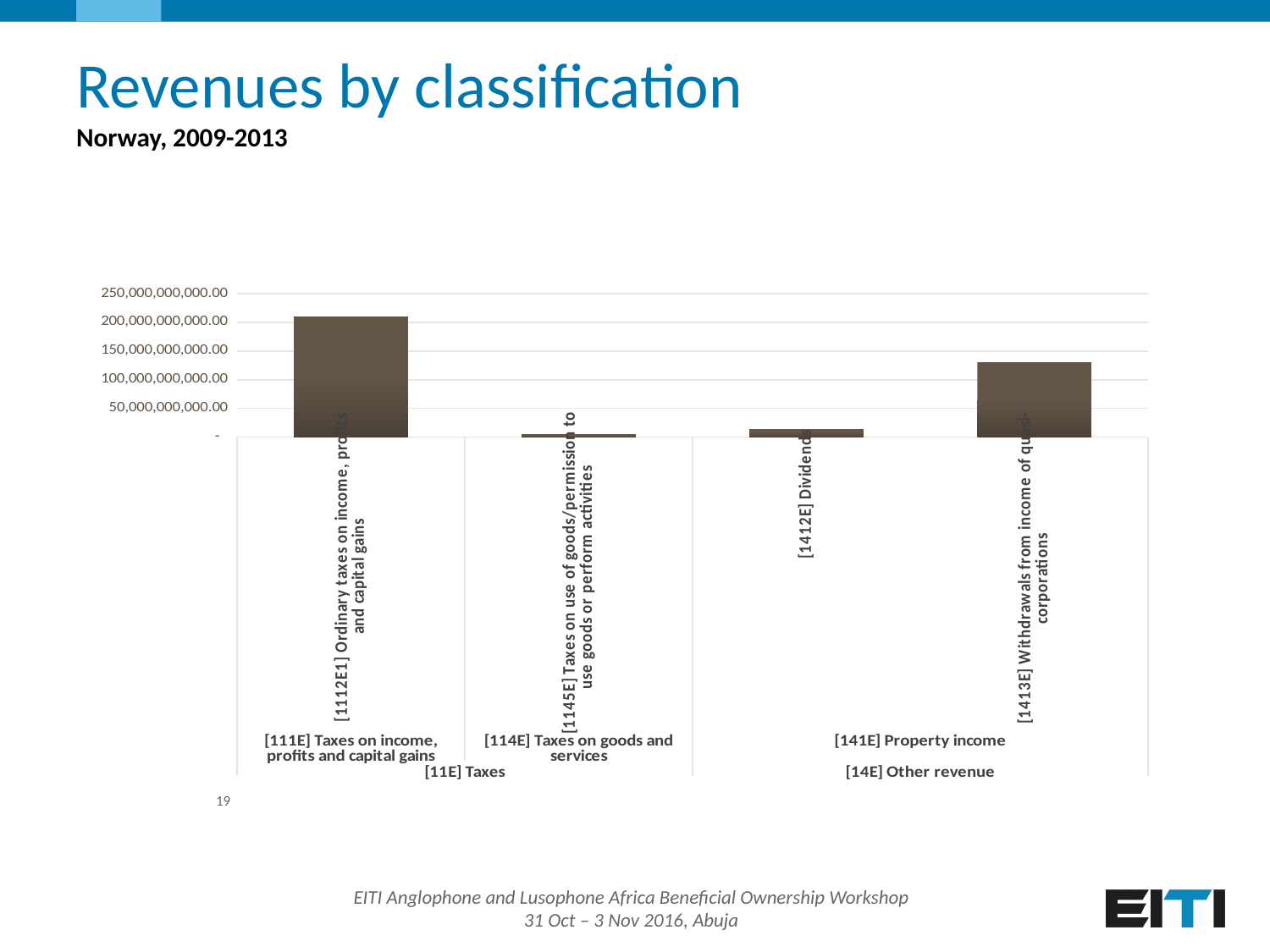
What kind of chart is shown on the slide? bar chart What is the title of the slide containing the chart? Revenues by classification Is the value for [1112E1] Ordinary taxes on income, profits and capital gains greater or less than 200,000,000,000.00? greater Which category has the lowest value in the chart? [1145E] Taxes on use of goods/permission to use goods or perform activities Is the value for [1412E] Dividends greater or less than 50,000,000,000.00? less Is the value for [1413E] Withdrawals from income of quasi-corporations greater or less than 100,000,000,000.00? greater Which category has the highest value in the chart? [1112E1] Ordinary taxes on income, profits and capital gains Which country and period does the chart cover, according to the subtitle? Norway, 2009-2013 Which is larger: the value for [1412E] Dividends or the value for [1413E] Withdrawals from income of quasi-corporations? [1413E] Withdrawals from income of quasi-corporations Which is larger: the value for [1112E1] Ordinary taxes on income, profits and capital gains or the value for [1413E] Withdrawals from income of quasi-corporations? [1112E1] Ordinary taxes on income, profits and capital gains How many bars are plotted in the chart? 4